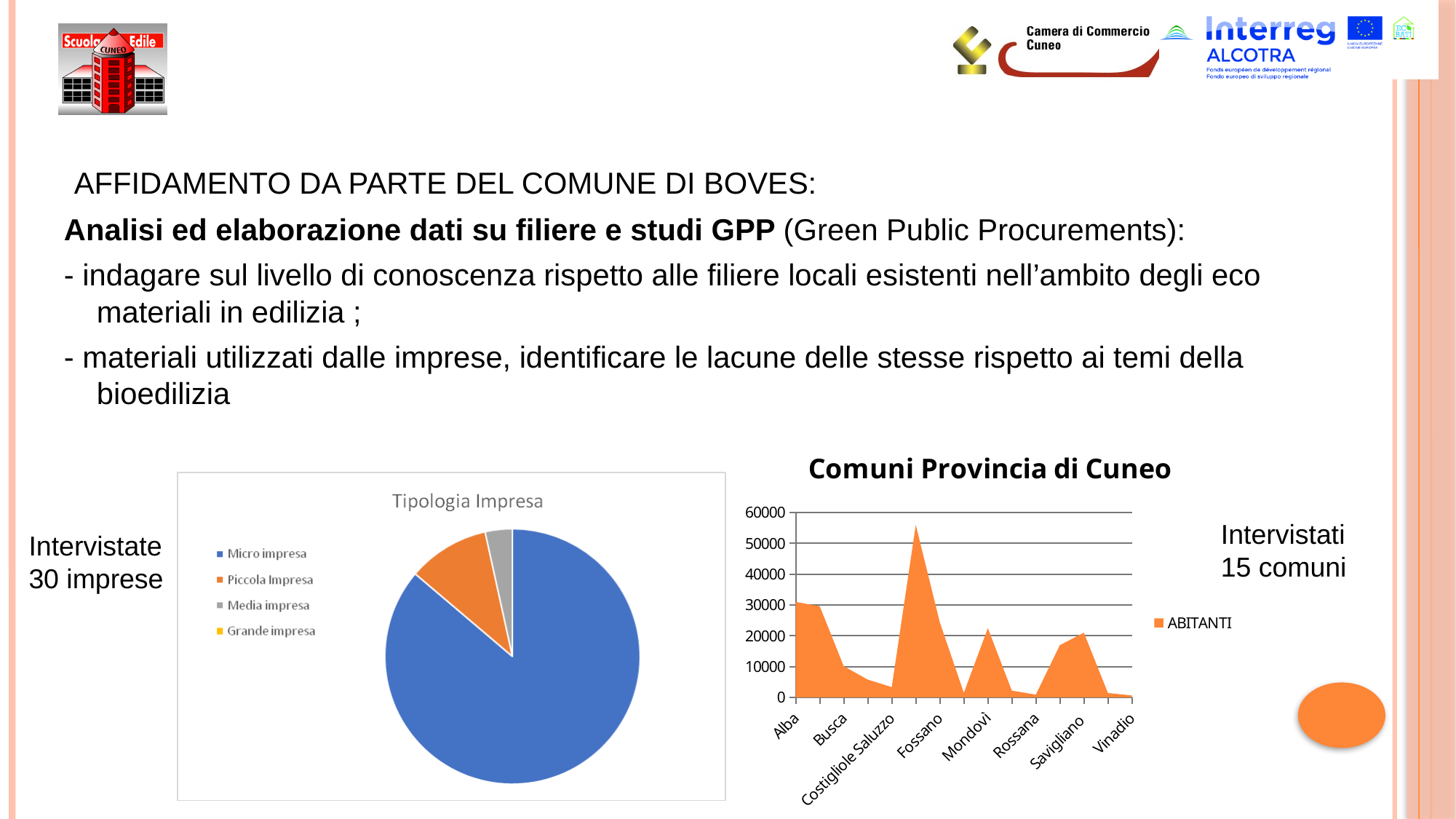
In the 'Comuni Provincia di Cuneo' chart, what is the name of the series shown in the legend? ABITANTI In the 'Comuni Provincia di Cuneo' chart, is the value for Fossano greater or less than 50000? less In the 'Tipologia Impresa' chart, which category has the largest slice? Micro impresa In the 'Comuni Provincia di Cuneo' chart, is the value for Alba greater or less than 20000? greater In the 'Comuni Provincia di Cuneo' chart, how many series does the legend list? 1 In the 'Tipologia Impresa' chart, how many entries does the legend list? 4 What kind of chart is the 'Tipologia Impresa' chart? pie chart In the 'Comuni Provincia di Cuneo' chart, is the value for Vinadio greater or less than 10000? less In the 'Tipologia Impresa' chart, which of Piccola Impresa and Media impresa has the larger slice? Piccola Impresa In the 'Comuni Provincia di Cuneo' chart, which of Alba and Fossano has the larger value? Alba What kind of chart is the 'Comuni Provincia di Cuneo' chart? area chart